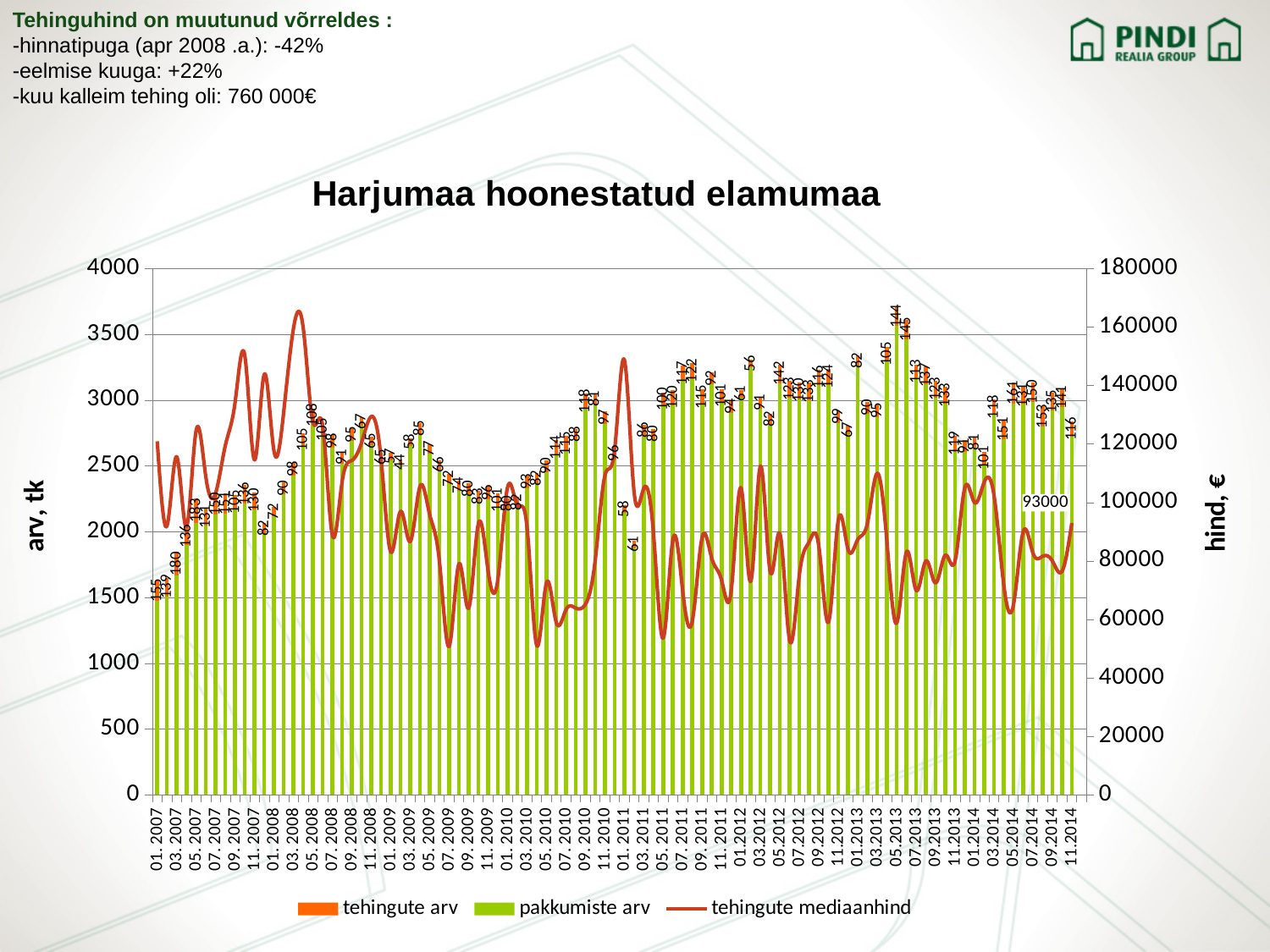
What is the value of tehingute mediaanhind labelled at the end of the line (11.2014)? 93000 Is the pakkumiste arv higher in 05.2013 or in 01.2007? 05.2013 Is the pakkumiste arv for 05.2013 greater or less than 3000? greater How many series does the chart legend list? 3 Is the tehingute mediaanhind at its peak in 04.2008 greater or less than 140000? greater Does the pakkumiste arv rise or fall from 01.2007 to 03.2008? rise Is the pakkumiste arv for 01.2007 greater or less than 2000? less What kind of chart is shown on the slide? A combined bar and line chart What is the title of the chart? Harjumaa hoonestatud elamumaa Which month has the highest pakkumiste arv? 05.2013 Which series is drawn as a line in the chart? tehingute mediaanhind